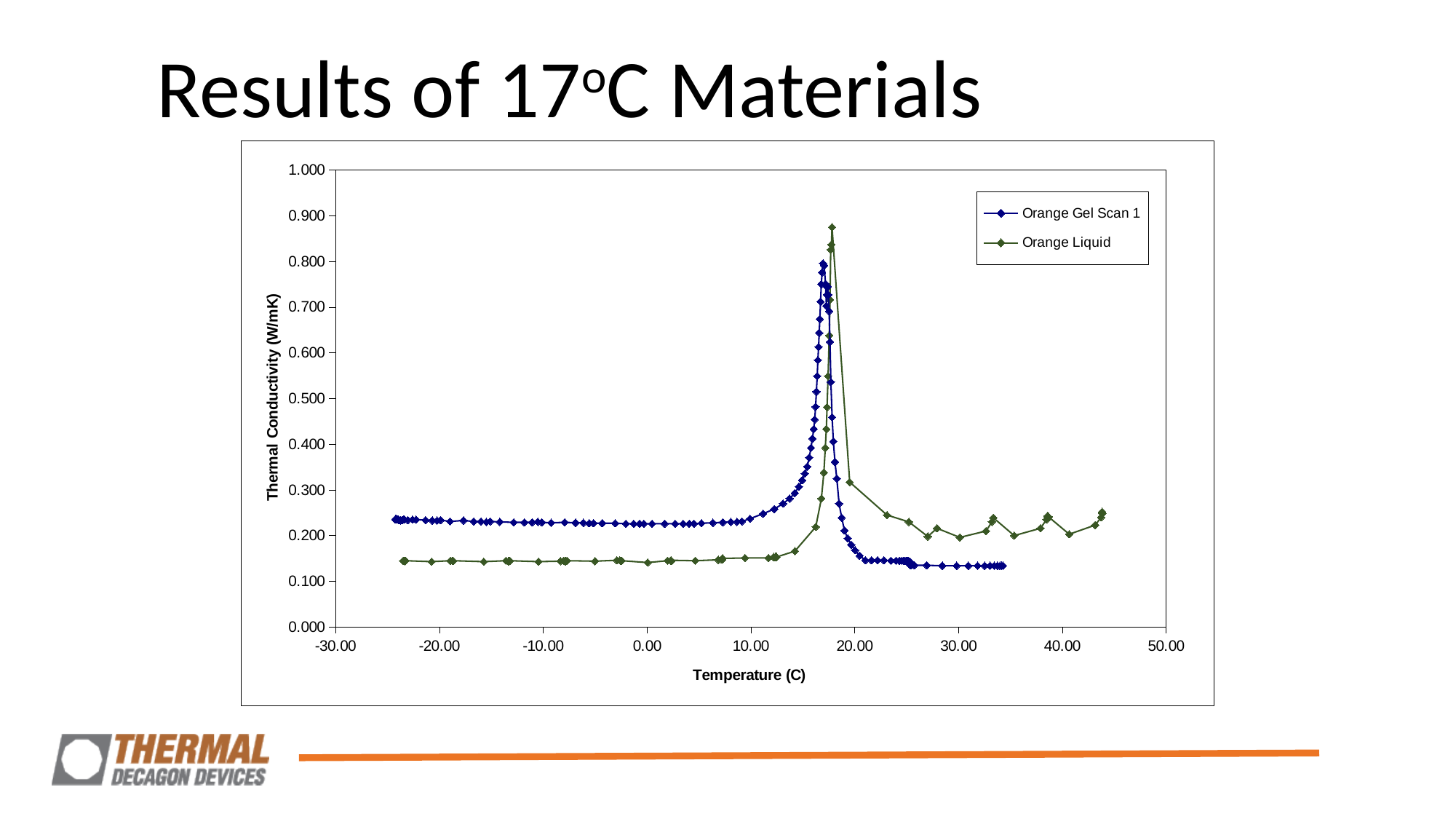
At -10.00 C, which series has the higher thermal conductivity? Orange Gel Scan 1 How many series does the legend list? 2 Is the peak value of the Orange Liquid series greater or less than 0.800? greater What kind of chart is shown on the slide? line chart Which series reaches the higher peak thermal conductivity? Orange Liquid What are the two series named in the legend? Orange Gel Scan 1 and Orange Liquid What is the title of the y axis? Thermal Conductivity (W/mK) Is the value of Orange Gel Scan 1 at -20.00 C greater or less than 0.300? less Is the value of Orange Liquid at -20.00 C greater or less than 0.200? less At 30.00 C, which series has the higher thermal conductivity? Orange Liquid Does the Orange Liquid series rise or fall between 10.00 C and its peak near 17 C? rise Does the Orange Gel Scan 1 series rise or fall between 17 C and 25.00 C? fall